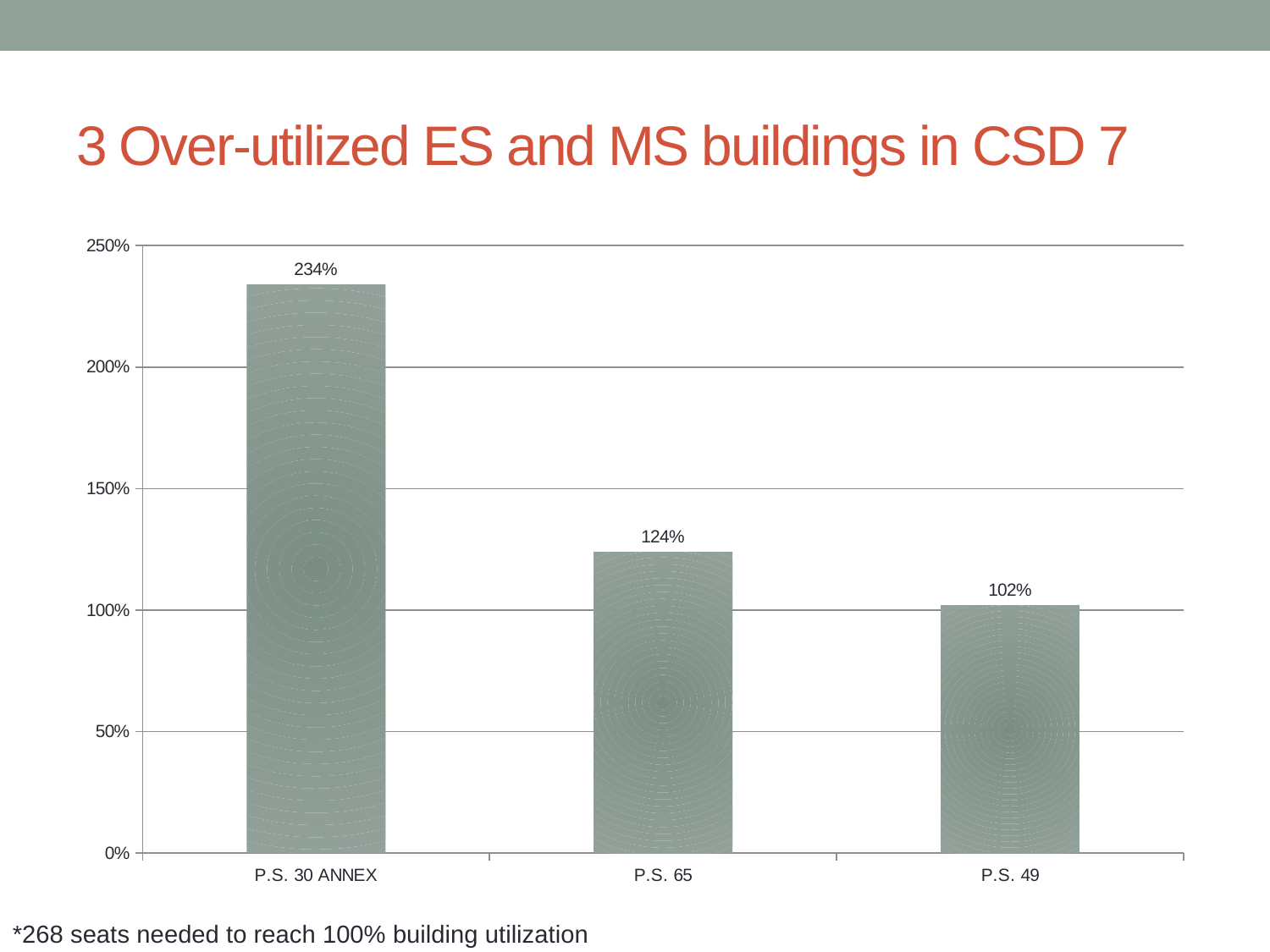
What is the utilization value for P.S. 65? 124% Which building has the lowest utilization? P.S. 49 Which building has the highest utilization? P.S. 30 ANNEX Which has a higher utilization, P.S. 65 or P.S. 49? P.S. 65 Do the values rise or fall from left to right across the x axis? Fall How many buildings are shown in the chart? 3 What kind of chart is shown on the slide? Bar chart What is the utilization value for P.S. 49? 102% What is the difference between the utilization of P.S. 65 and P.S. 49? 22% What is the difference between the utilization of P.S. 30 ANNEX and P.S. 65? 110% What is the utilization value for P.S. 30 ANNEX? 234% Is the value for P.S. 30 ANNEX greater or less than 200%? greater